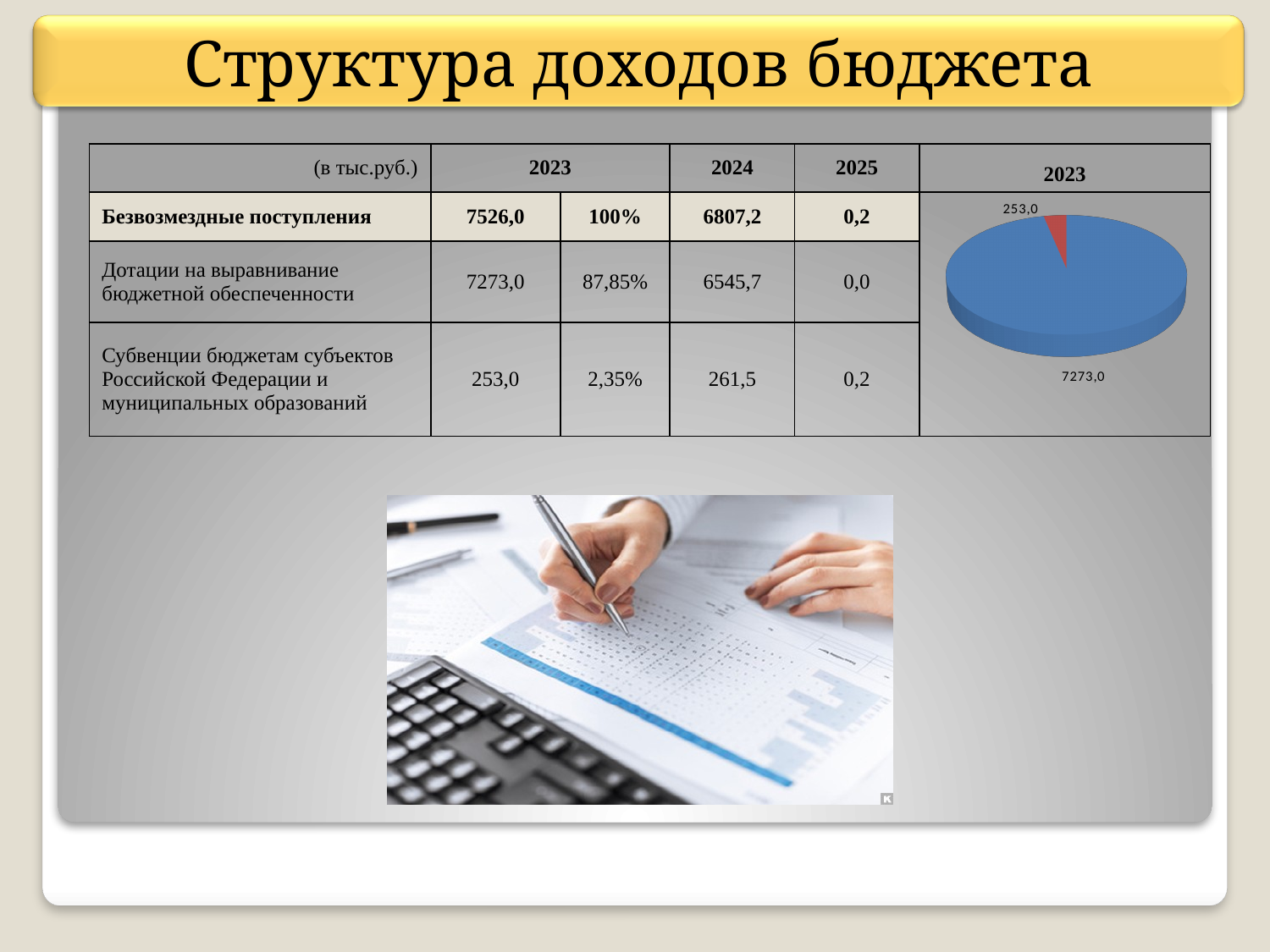
What is the title of the pie chart? 2023 What value is printed on the small red slice of the pie chart? 253,0 Which slice of the pie chart is the largest? 7273,0 What kind of chart is shown on the slide? pie chart What is the difference between the two slice values in the pie chart? 7020,0 How many slices does the pie chart have? 2 What value is printed on the large blue slice of the pie chart? 7273,0 What colour is the smaller slice of the pie chart? red What is the total of the two slice values shown in the pie chart? 7526,0 Which is larger in the pie chart: the blue slice or the red slice? the blue slice Which slice of the pie chart is the smallest? 253,0